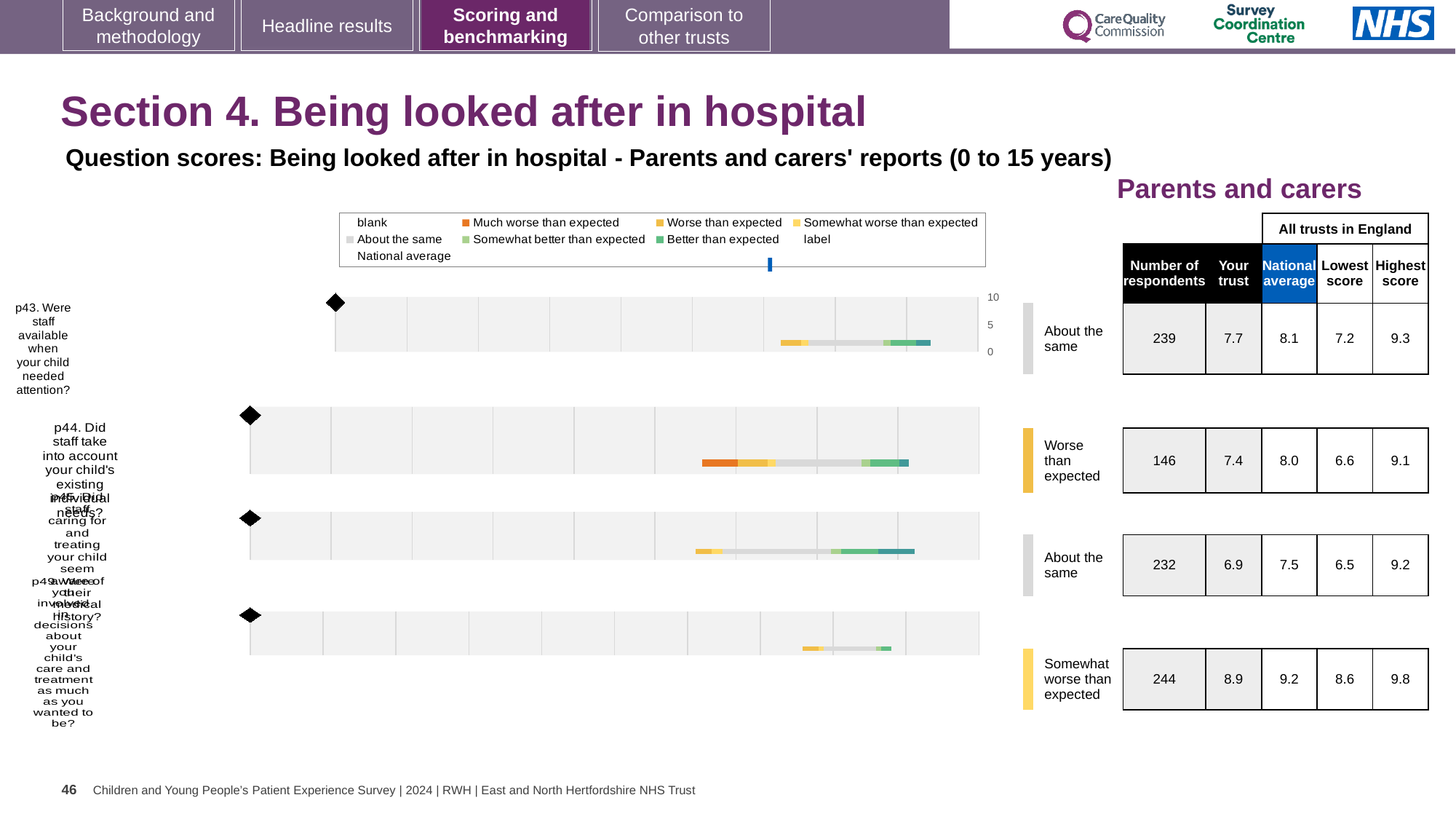
What is the lowest score among all trusts in England for p49? 8.6 For p43 (Were staff available when your child needed attention?), what is the 'Your trust' score? 7.7 What is the highest score among all trusts in England for p45? 9.2 Which question has the lowest 'Your trust' score? p45 How many questions (bar rows) are plotted on the slide? 4 Which question has the highest 'Your trust' score? p49 What benchmark category is shown for p44? Worse than expected For p44, which is larger: the 'Your trust' score or the national average? National average For p44 (Did staff take into account your child's existing individual needs?), what is the national average score? 8.0 For p43, what is the difference between the national average and the 'Your trust' score? 0.4 What kind of chart is used to show the question scores on this slide? bar chart How many respondents are listed for the fourth question row (p49)? 244